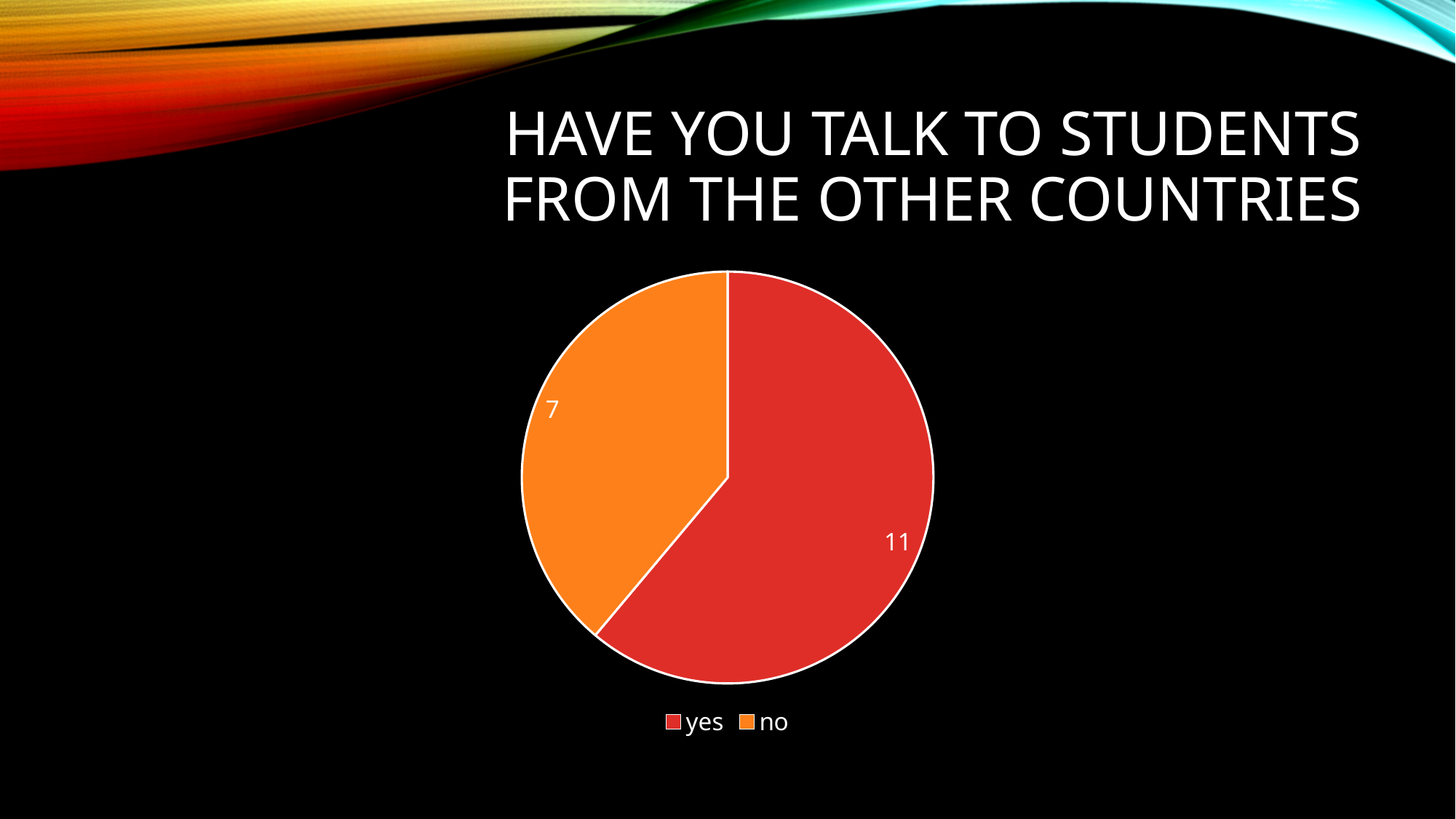
What is the title of the slide containing the chart? HAVE YOU TALK TO STUDENTS FROM THE OTHER COUNTRIES How many categories does the pie chart have? 2 What is the value for "no"? 7 What kind of chart is shown on the slide? pie chart Which is larger, the value for "yes" or the value for "no"? yes Which category has the smallest slice? no What colour is the "no" slice? orange What is the difference between the "yes" and "no" values? 4 What is the total of all slices in the pie chart? 18 How many entries does the legend list? 2 Which category has the largest slice? yes What is the value for "yes"? 11